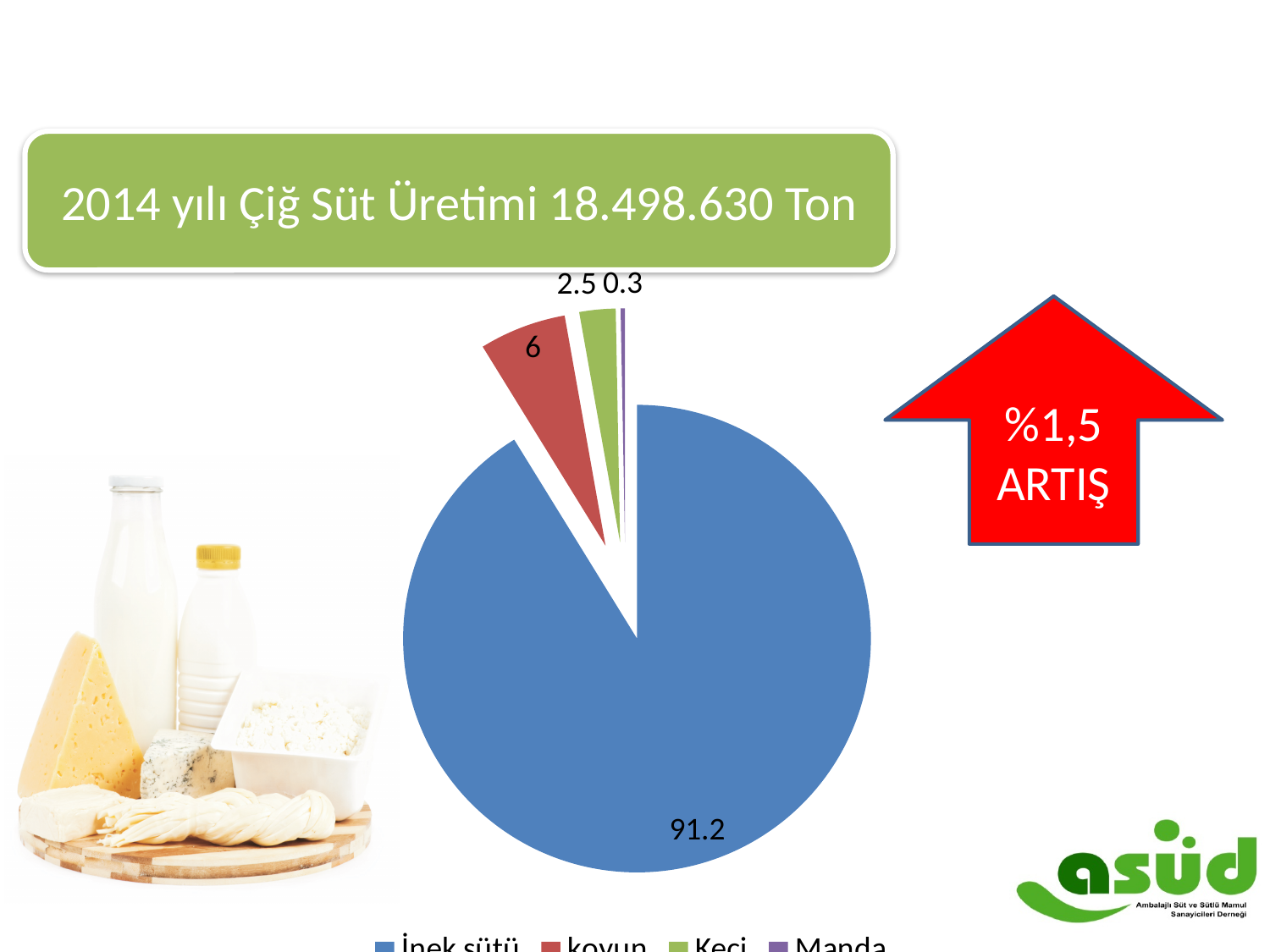
What is the value shown for the koyun slice of the pie chart? 6 What colour is the İnek sütü slice in the pie chart? blue How many slices does the pie chart have? 4 Which category has the largest slice in the pie chart? İnek sütü Which is larger in the pie chart, the koyun slice or the Keçi slice? koyun How many entries does the legend of the pie chart list? 4 What is the difference between the koyun value and the Keçi value in the pie chart? 3.5 What is the value shown for the Manda slice of the pie chart? 0.3 What is the value shown for the İnek sütü slice of the pie chart? 91.2 What kind of chart is shown on the slide? pie chart What is the value shown for the Keçi slice of the pie chart? 2.5 Which category has the smallest slice in the pie chart? Manda